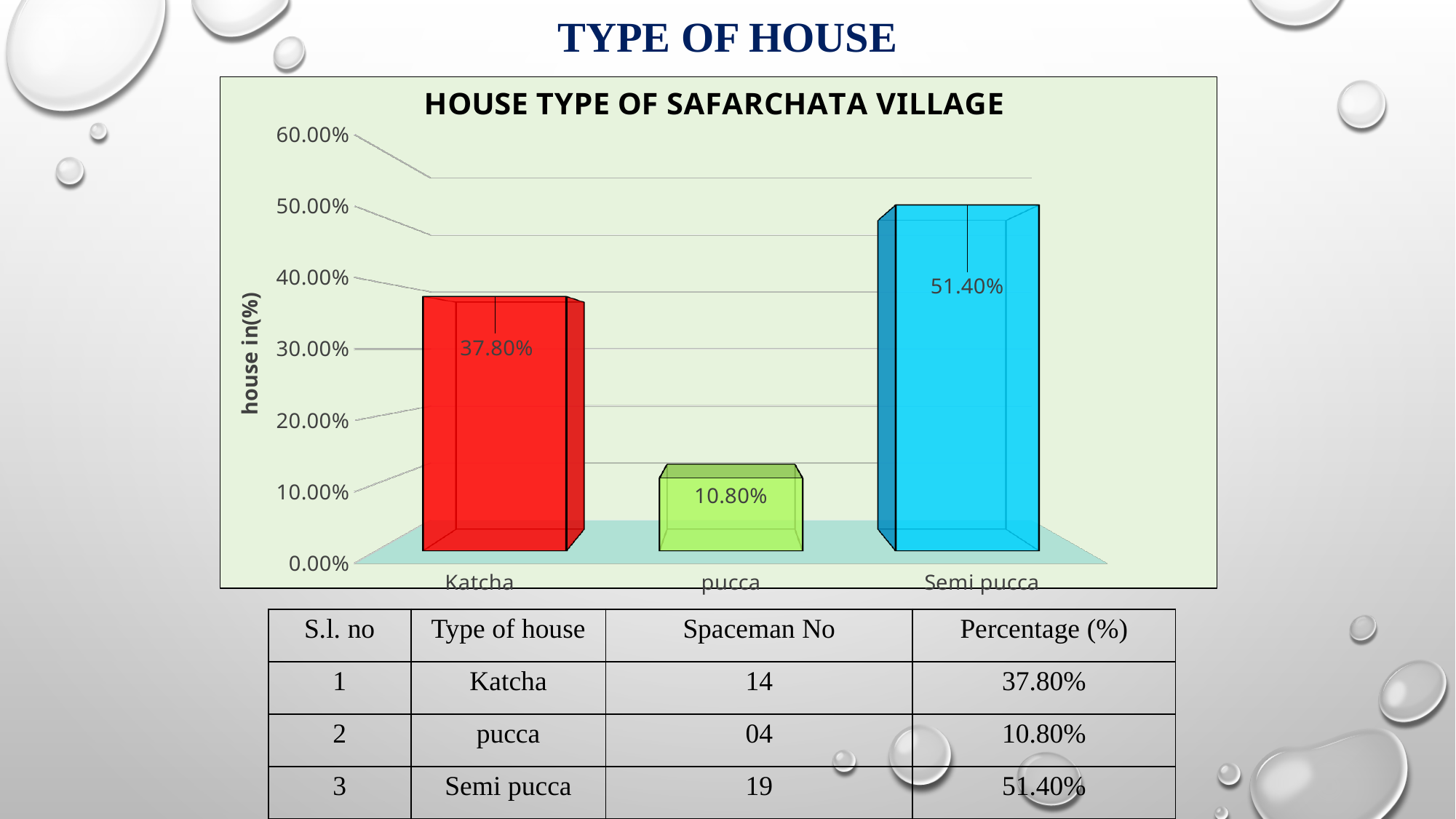
How many house type categories are shown in the chart? 3 What is the difference between the values for Katcha and pucca? 27.00% Which is larger, the value for Katcha or the value for Semi pucca? Semi pucca What is the difference between the values for Semi pucca and Katcha? 13.60% What is the title of the chart? HOUSE TYPE OF SAFARCHATA VILLAGE What is the value for pucca in the chart? 10.80% What is the value for Katcha in the chart? 37.80% Is the value for Semi pucca greater or less than 50.00%? greater Which house type has the lowest percentage in the chart? pucca What kind of chart is shown on the slide? bar chart Which house type has the highest percentage in the chart? Semi pucca What is the value for Semi pucca in the chart? 51.40%